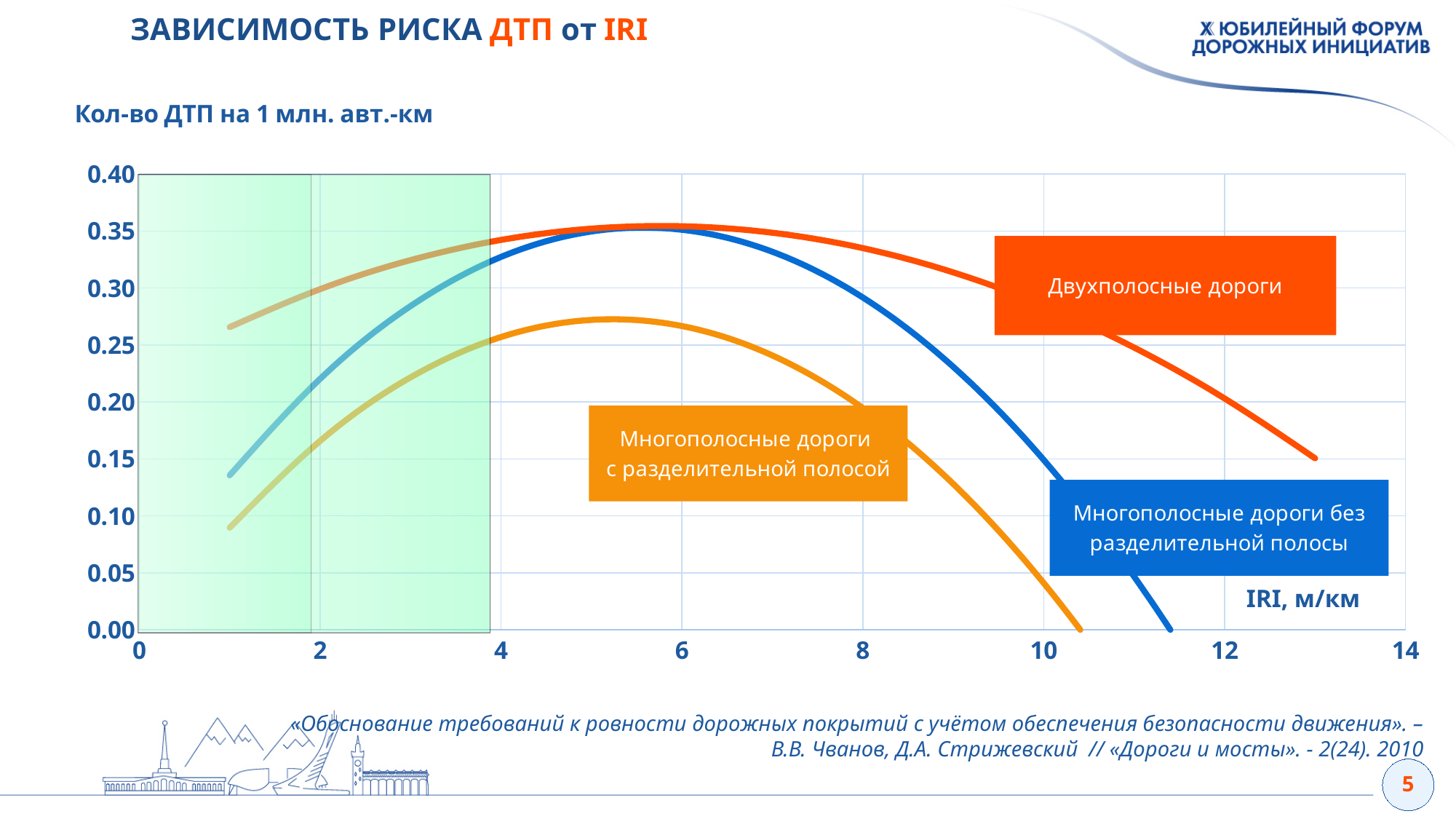
What is the label of the x axis of the chart? IRI, м/км Which curve has the lowest peak value? Многополосные дороги с разделительной полосой Does the 'Двухполосные дороги' curve rise or fall between IRI = 6 and IRI = 13? fall Is the value of the 'Многополосные дороги без разделительной полосы' curve at IRI = 8 greater or less than 0.25? greater At IRI = 2, which curve is higher: 'Двухполосные дороги' or 'Многополосные дороги без разделительной полосы'? Двухполосные дороги Is the value of the 'Многополосные дороги с разделительной полосой' curve at IRI = 1 greater or less than 0.10? less Is the value of the 'Двухполосные дороги' curve at IRI = 10 greater or less than 0.25? greater What kind of chart is shown on the slide? line chart What quantity is plotted on the y axis, according to the label above the chart? Кол-во ДТП на 1 млн. авт.-км How many curves (series) are plotted on the chart? 3 At IRI = 10, which curve is higher: 'Многополосные дороги без разделительной полосы' or 'Многополосные дороги с разделительной полосой'? Многополосные дороги без разделительной полосы